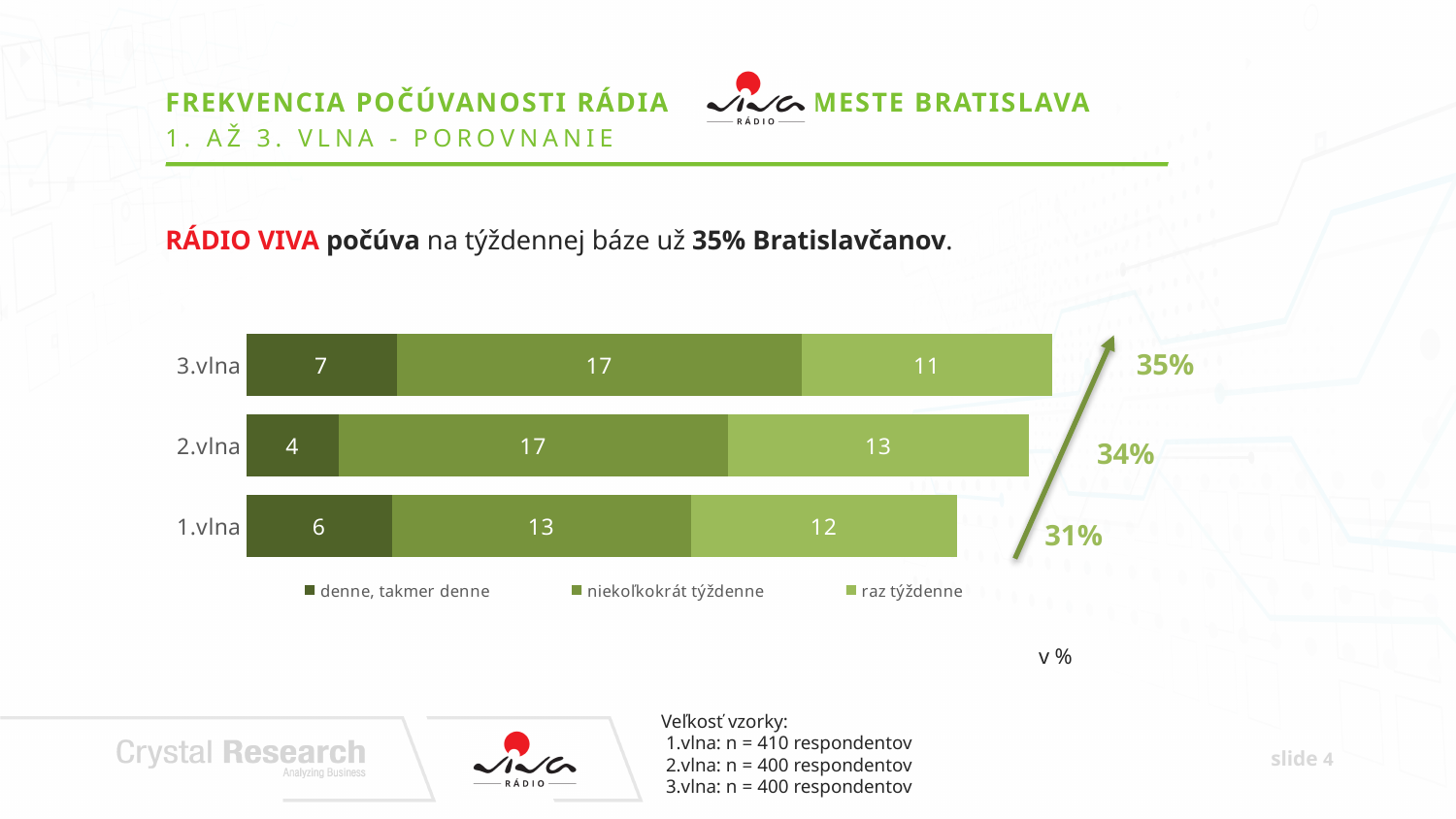
What is the total of the stacked bar for 3.vlna? 35% What is the difference between the 'raz týždenne' values for 2.vlna and 3.vlna? 2 Which wave has the lowest value for 'denne, takmer denne'? 2.vlna How many series does the legend list? 3 What is the total of the stacked bar for 1.vlna? 31% What kind of chart is shown on the slide? stacked bar chart Which wave has the highest total? 3.vlna What is the value for 'denne, takmer denne' in 3.vlna? 7 Which is larger: the 'niekoľkokrát týždenne' value for 2.vlna or for 1.vlna? 2.vlna What is the value for 'raz týždenne' in 2.vlna? 13 How many categories (waves) are plotted on the chart? 3 What is the value for 'niekoľkokrát týždenne' in 1.vlna? 13